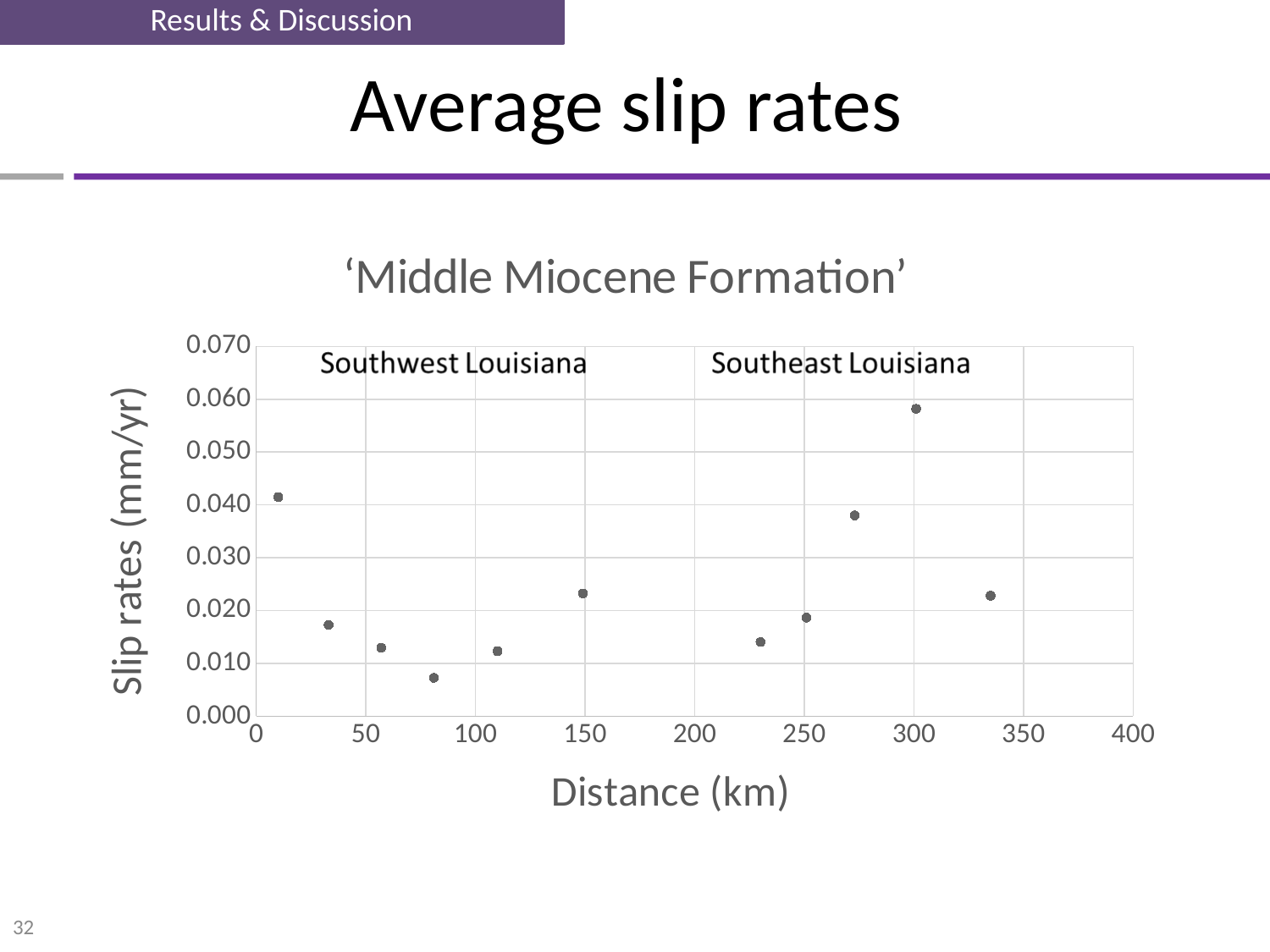
What are the two region labels shown inside the plot area? Southwest Louisiana and Southeast Louisiana What is the title of the chart? 'Middle Miocene Formation' Is the slip rate for the point near 300 km greater or less than 0.050 mm/yr? greater Which has the higher slip rate: the point near 300 km or the point near 10 km? The point near 300 km How many data points are plotted on the chart? 11 Which has the higher slip rate: the point near 335 km or the point near 230 km? The point near 335 km Is the slip rate for the point near 273 km greater or less than 0.030 mm/yr? greater Is the slip rate for the point near 230 km greater or less than 0.020 mm/yr? less What kind of chart is shown on the slide? Scatter chart